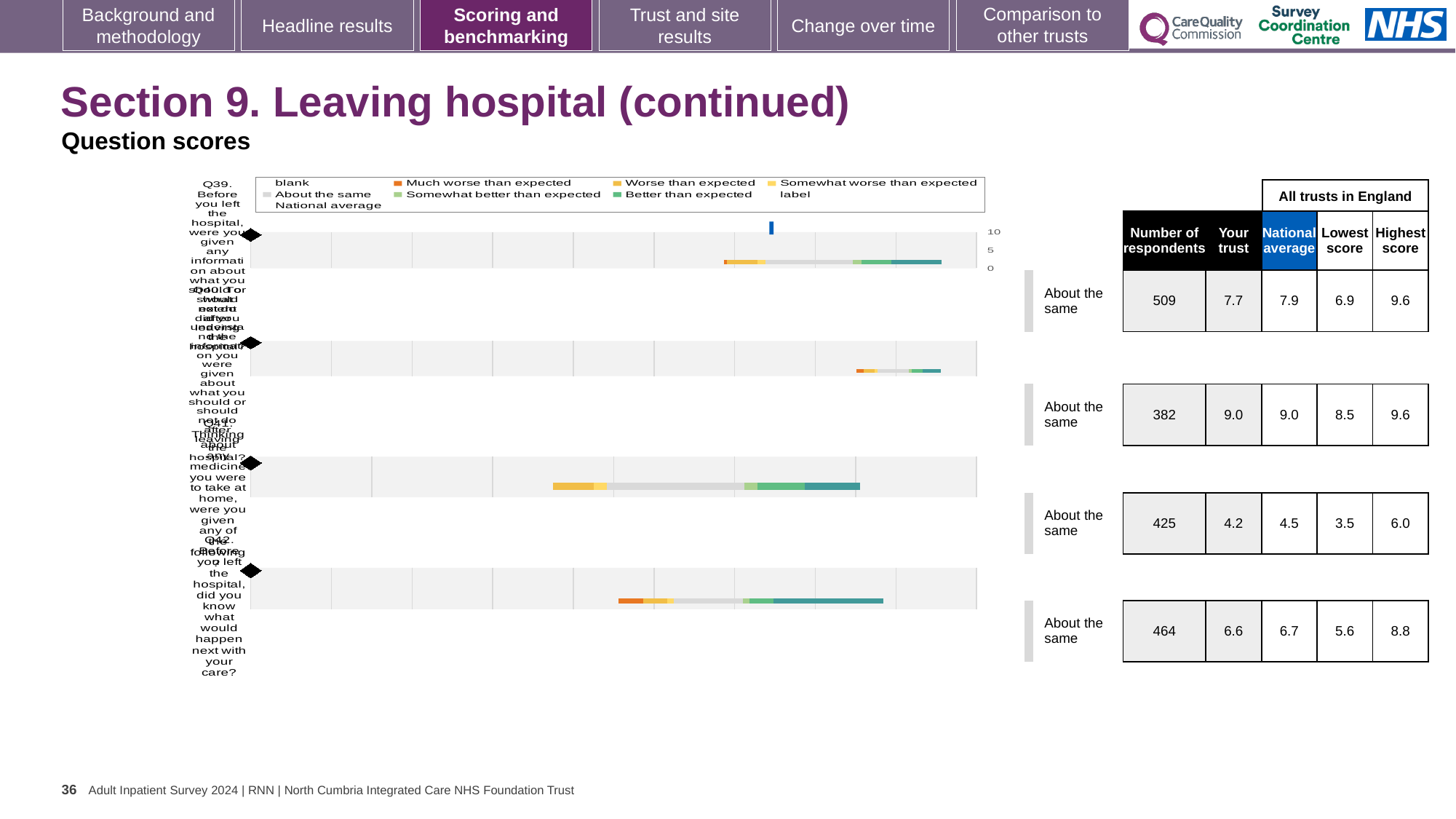
What kind of chart is used to show the question scores on this slide? bar chart Which chart on the slide has the lowest 'Your trust' score? the third chart from the top (4.2) What benchmark category is shown next to each of the four charts? About the same For the Q39 chart, which is larger: the 'Your trust' score or the 'National average'? National average Is the 'Your trust' score for the Q39 chart greater or less than 5? greater For the Q39 chart (Before you left the hospital, were you given any information about what you should or should not do after leaving), what is the 'Your trust' score shown in the table? 7.7 How many question charts are shown on the slide? 4 For the Q42 chart (Before you left the hospital, did you know what would happen next with your care), how many respondents are shown in the table? 464 What is the maximum value shown on the axis scale above the first chart? 10 For the Q42 chart, what is the difference between the highest score (8.8) and the lowest score (5.6)? 3.2 Which chart on the slide has the highest 'Your trust' score? the second chart from the top (9.0) For the Q42 chart, what is the highest score among all trusts in England? 8.8